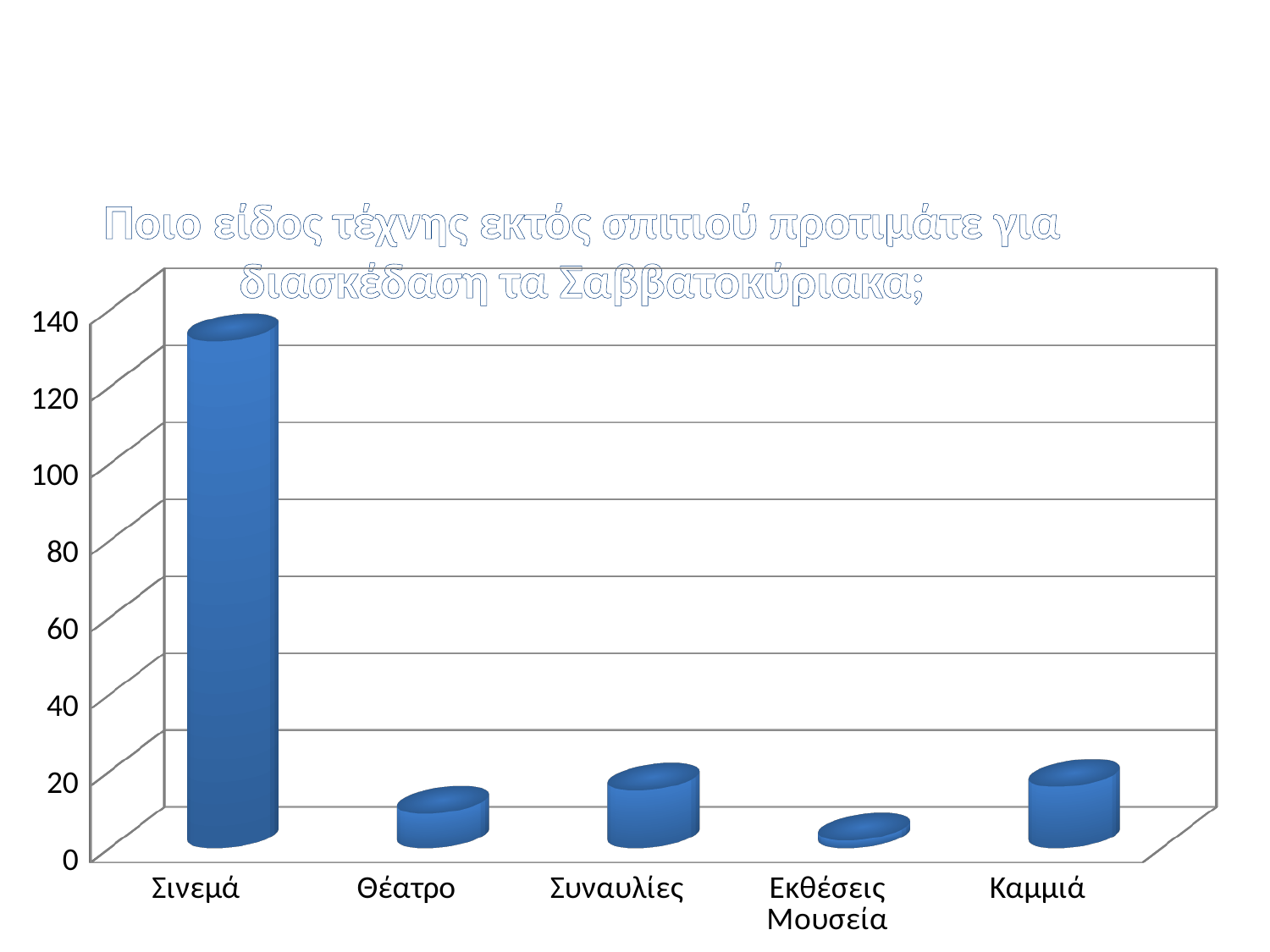
Is the value for Θέατρο greater or less than 20? less Which category has the highest value in the chart? Σινεμά Which category has the lowest value in the chart? Εκθέσεις Μουσεία Is the value for Καμμιά greater or less than 40? less How many categories are shown on the x axis of the chart? 5 Which has a larger value, Θέατρο or Εκθέσεις Μουσεία? Θέατρο What is the title of the chart? Ποιο είδος τέχνης εκτός σπιτιού προτιμάτε για διασκέδαση τα Σαββατοκύριακα; Which has a larger value, Σινεμά or Θέατρο? Σινεμά Is the value for Εκθέσεις Μουσεία greater or less than 20? less What is the highest value shown on the vertical axis of the chart? 140 What kind of chart is shown on the slide? bar chart